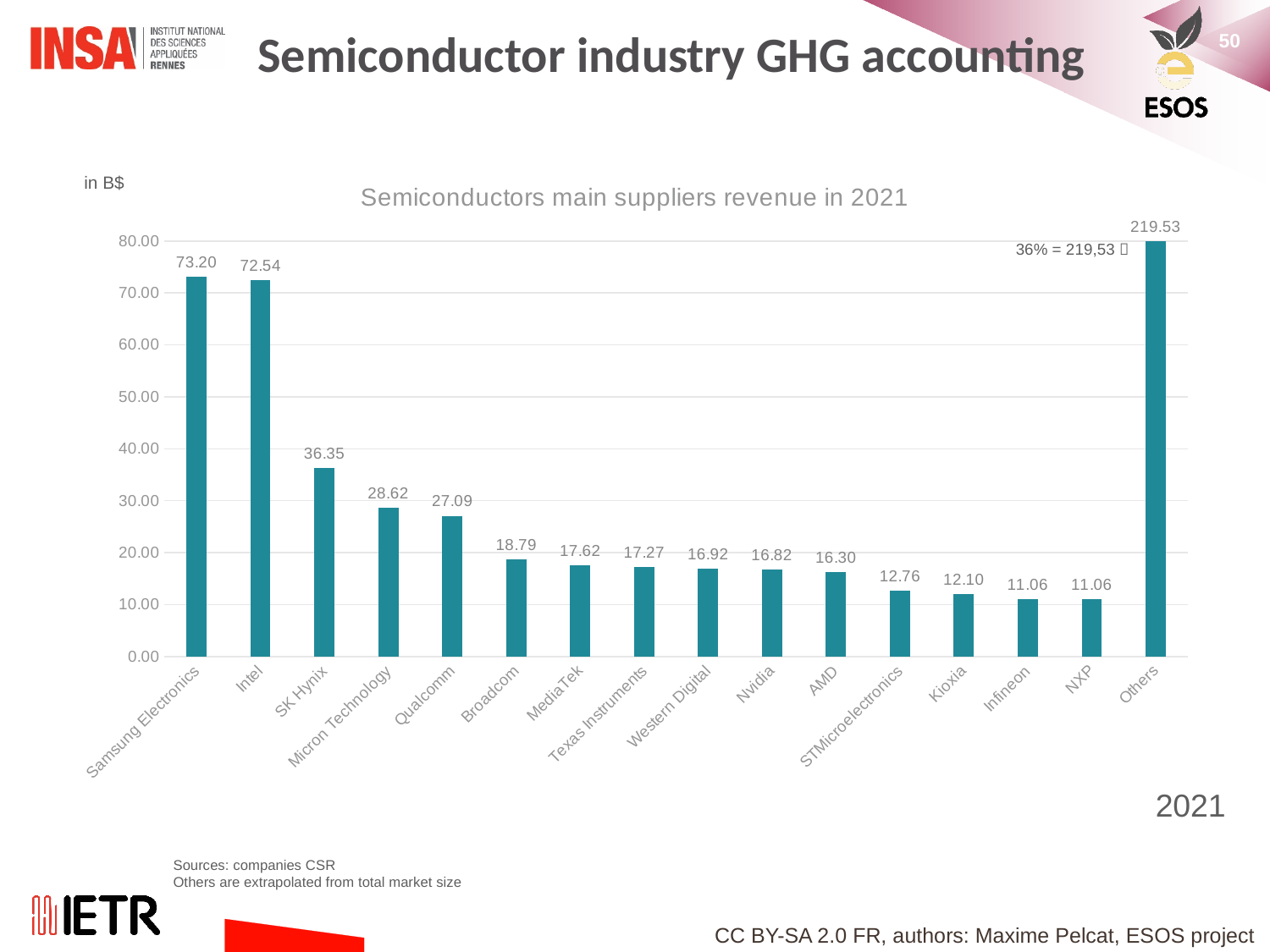
What is the revenue value shown for SK Hynix? 36.35 Which has a larger value, Micron Technology or Broadcom? Micron Technology How many categories (bars) are shown on the x axis? 16 What is the value shown for the Others bar? 219.53 What is the difference between the values for Samsung Electronics and SK Hynix? 36.85 What is the revenue value shown for Nvidia? 16.82 What type of chart is shown on the slide? bar chart Which category has the highest value in the chart? Others Excluding the Others bar, do the values rise or fall from left to right along the x axis? fall Is the value for Intel greater or less than 70.00? greater What is the title of the chart? Semiconductors main suppliers revenue in 2021 What is the revenue value shown for Samsung Electronics? 73.20